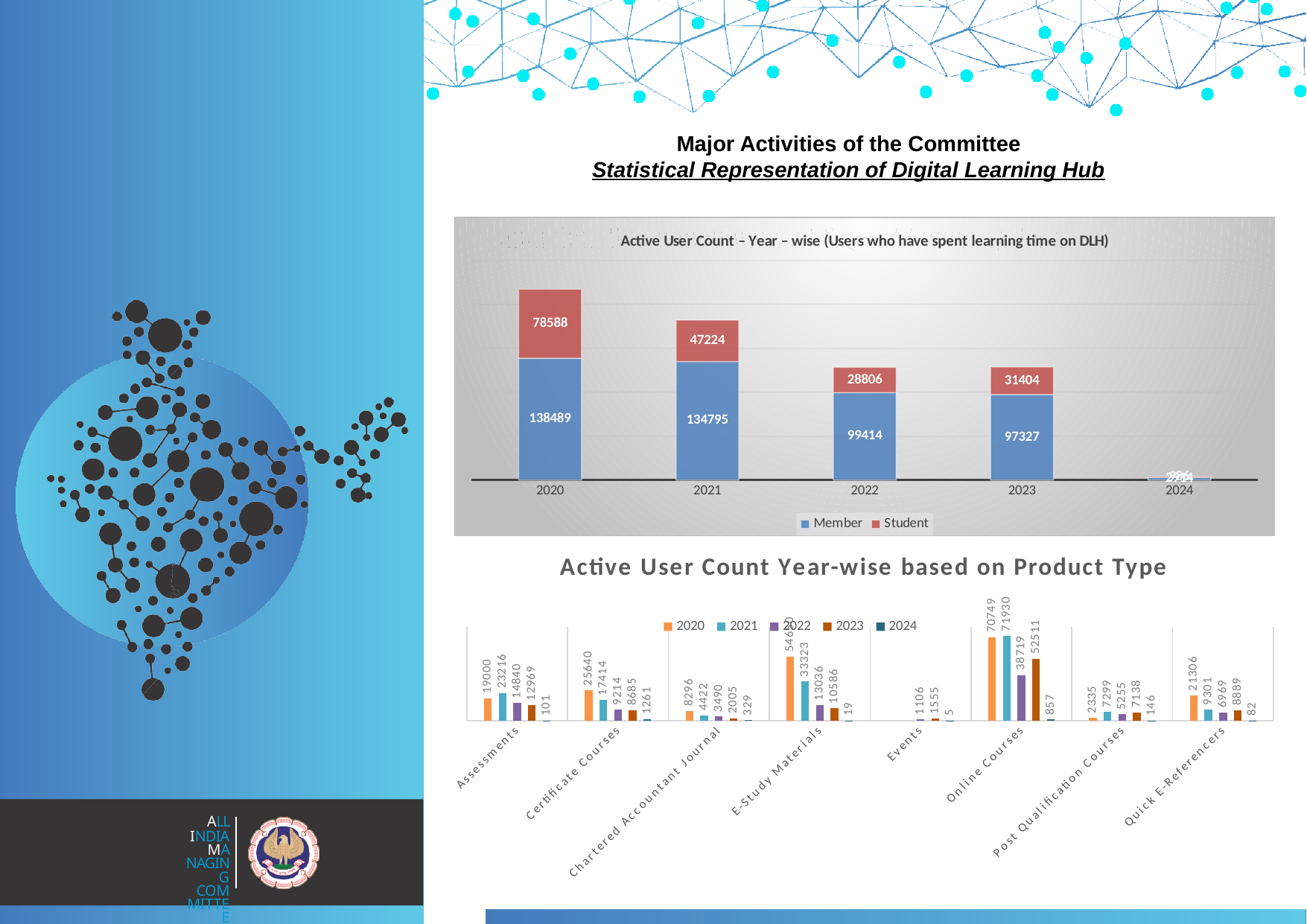
In the 'Active User Count – Year – wise' chart, what is the Student value for 2021? 47224 In the 'Active User Count – Year – wise' chart, what is the Member value for 2020? 138489 In the 'Active User Count Year-wise based on Product Type' chart, which product type has the highest 2020 value? Online Courses In the 'Active User Count – Year – wise' chart, how many series does the legend list? 2 In the 'Active User Count Year-wise based on Product Type' chart, what is the 2021 value for Online Courses? 71930 In the 'Active User Count – Year – wise' chart, what kind of chart is it? Stacked bar chart In the 'Active User Count Year-wise based on Product Type' chart, how many product type categories are shown? 8 In the 'Active User Count Year-wise based on Product Type' chart, what is the 2020 value for Quick E-Referencers? 21306 In the 'Active User Count Year-wise based on Product Type' chart, which is larger for Assessments: the 2020 value or the 2021 value? 2021 In the 'Active User Count – Year – wise' chart, which year has the highest Student value? 2020 In the 'Active User Count – Year – wise' chart, what is the total of the stacked bar for 2022? 128220 In the 'Active User Count – Year – wise' chart, what is the difference between the Member values for 2020 and 2021? 3694